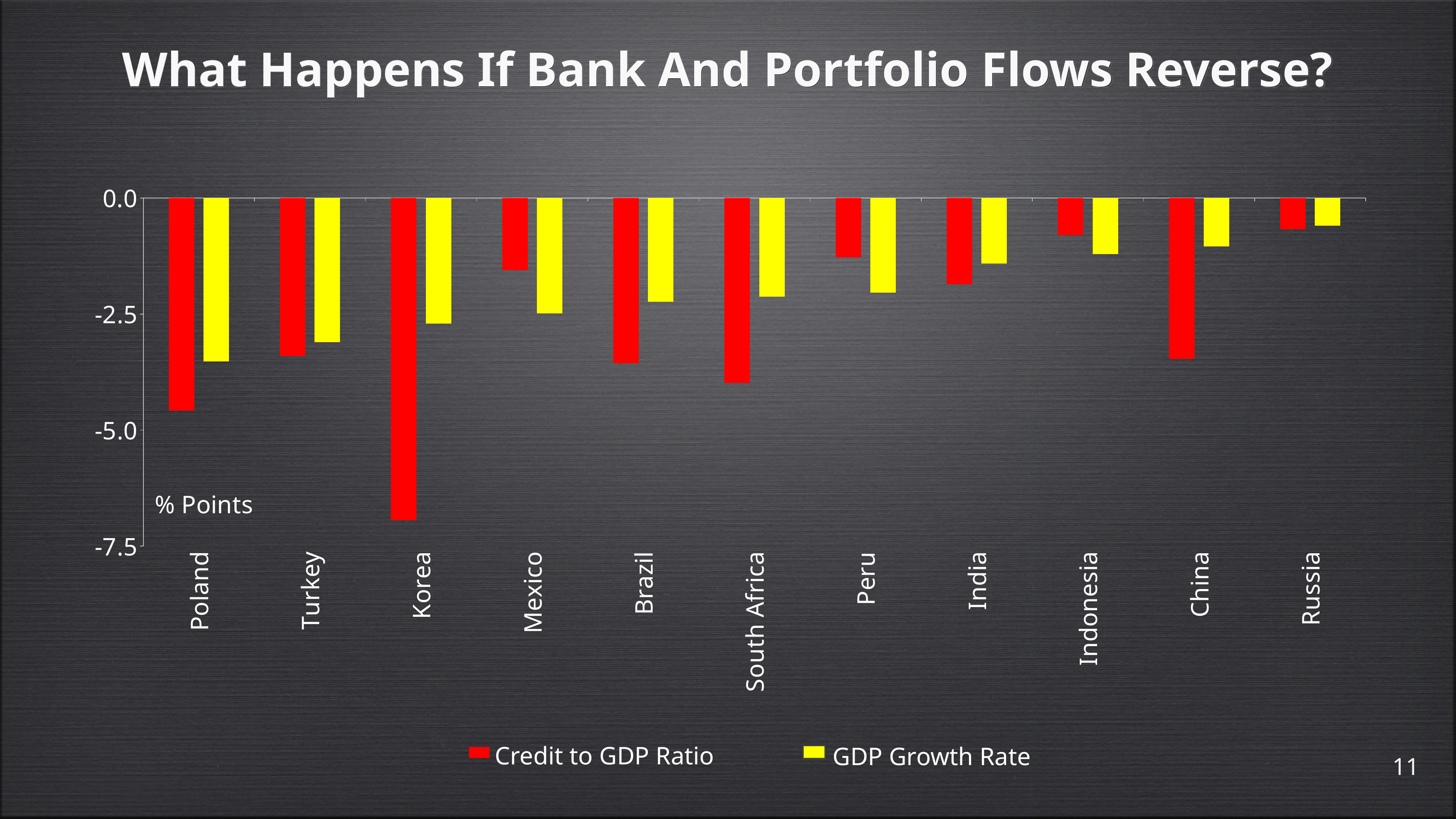
Which country has the lowest (most negative) Credit to GDP Ratio value? Korea Which country has the lowest (most negative) GDP Growth Rate value? Poland Is the Credit to GDP Ratio value for Korea greater or less than -5.0? less What kind of chart is shown on the slide? bar chart Is the Credit to GDP Ratio value for Poland greater or less than -5.0? greater Which country has the highest (least negative) GDP Growth Rate value? Russia Is the GDP Growth Rate value for Turkey greater or less than -2.5? less How many series does the chart's legend list? 2 Do the GDP Growth Rate values rise or fall moving from Poland on the left to Russia on the right? rise For Brazil, which series has the lower (more negative) value: Credit to GDP Ratio or GDP Growth Rate? Credit to GDP Ratio How many countries are shown on the x axis of the chart? 11